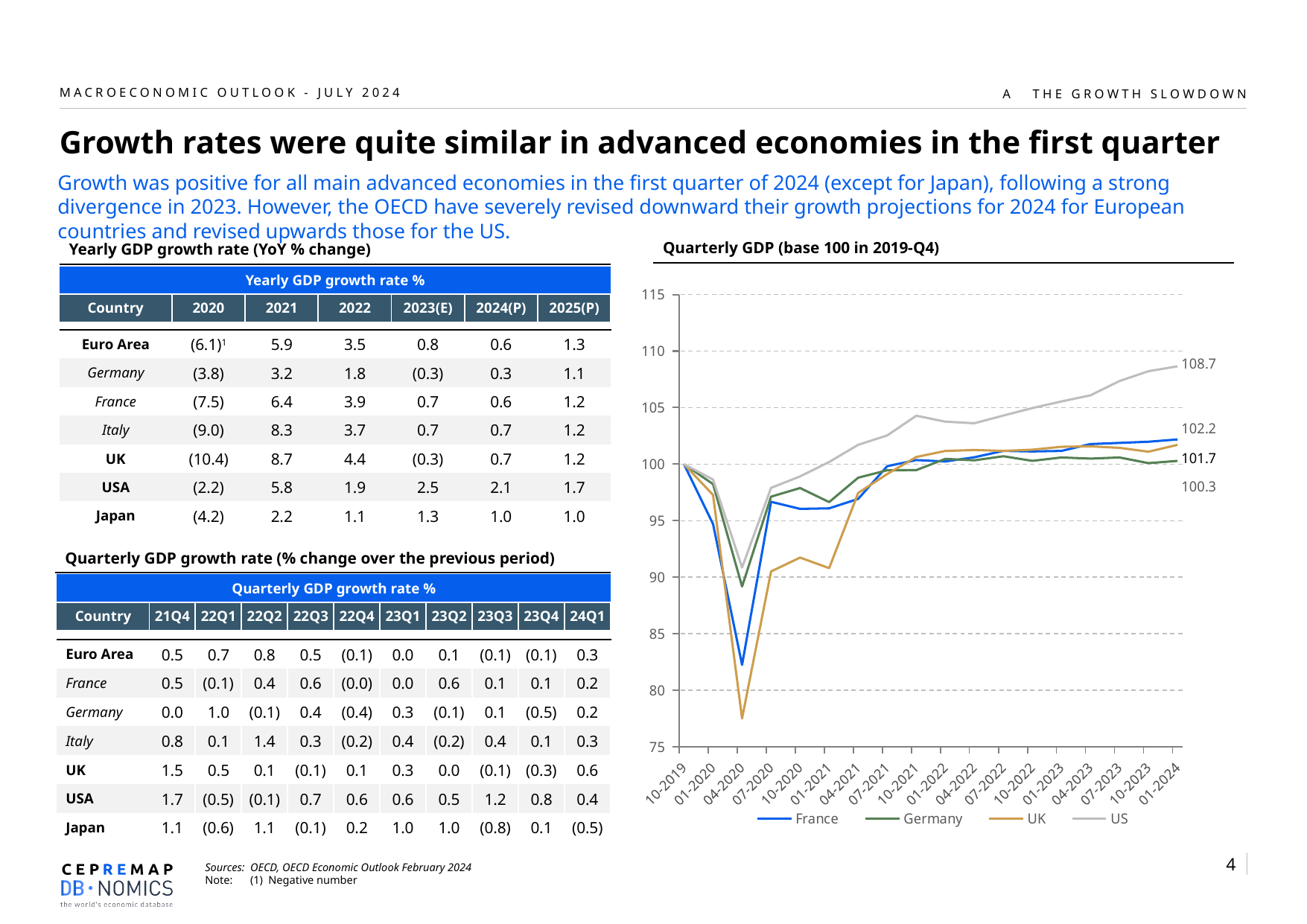
What kind of chart is the 'Quarterly GDP (base 100 in 2019-Q4)' chart? line chart In the Quarterly GDP chart, which country has the lowest value at 01-2024? Germany In the Quarterly GDP chart, which is larger at 01-2024: the France value or the UK value? France In the Quarterly GDP chart, does the US series rise or fall from 07-2020 to 01-2024? rise In the Quarterly GDP chart, which country has the highest value at 01-2024? US How many series does the legend of the Quarterly GDP chart list? 4 In the Quarterly GDP chart, what is the difference between the US value (108.7) and the France value (102.2) at 01-2024? 6.5 In the Quarterly GDP chart, what is the labelled value of the US series at the end of the period (01-2024)? 108.7 In the Quarterly GDP chart, what is the labelled value of the France series at 01-2024? 102.2 Which countries are listed in the legend of the Quarterly GDP chart? France, Germany, UK, US In the Quarterly GDP chart, what is the labelled value of the Germany series at 01-2024? 100.3 In the Quarterly GDP chart, is the value for the UK in 04-2020 greater or less than 80? less